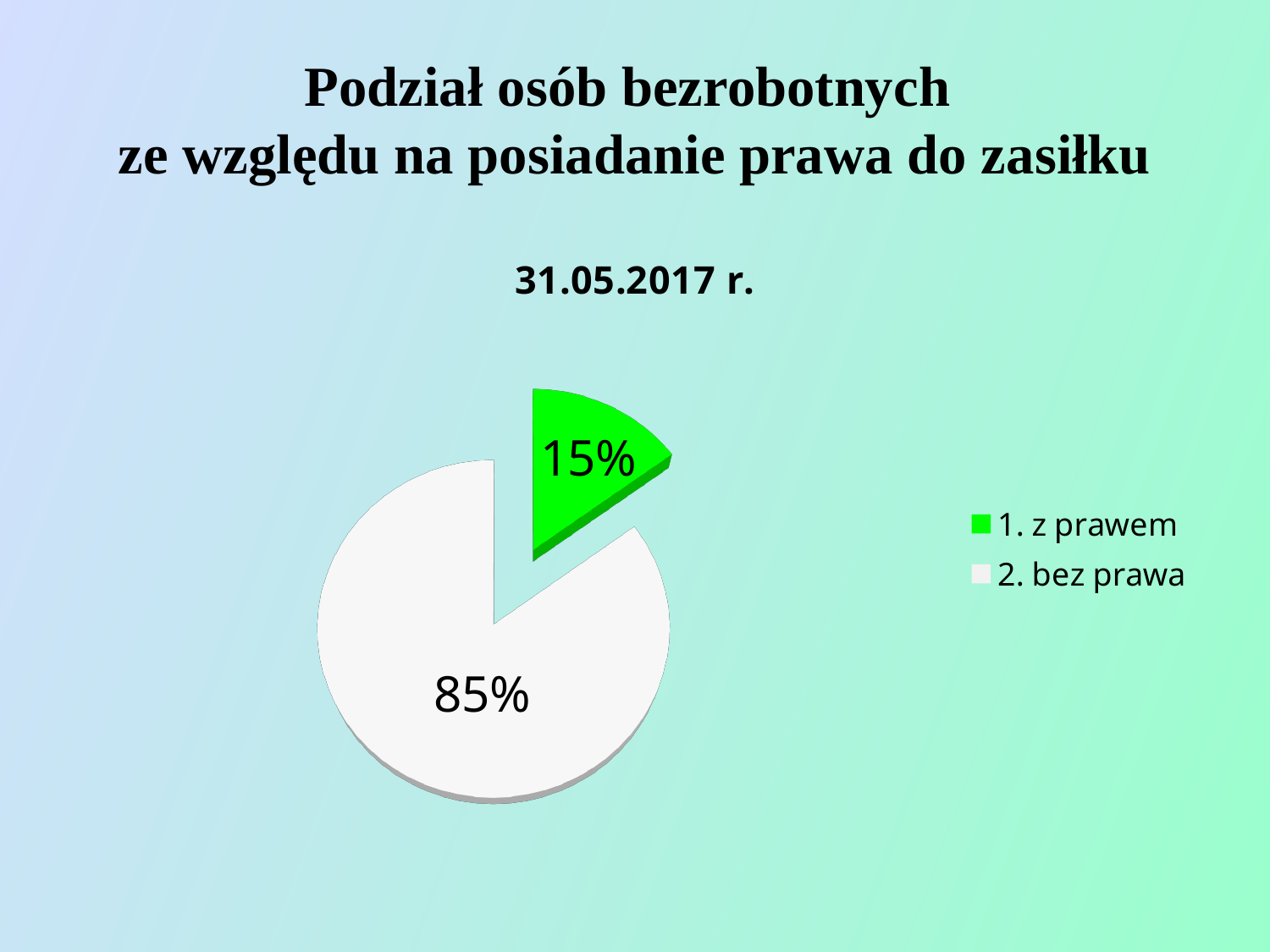
What share of the pie does "1. z prawem" represent? 15% Which is larger, the share for "1. z prawem" or for "2. bez prawa"? 2. bez prawa What is the difference in percentage points between "2. bez prawa" and "1. z prawem"? 70 What kind of chart is shown on the slide? pie chart How many entries does the legend list? 2 What colour is the slice for "1. z prawem"? green What share of the pie does "2. bez prawa" represent? 85% Which slice of the pie is the smallest? 1. z prawem How many slices does the pie chart have? 2 Which slice of the pie is the largest? 2. bez prawa What date is shown above the chart? 31.05.2017 r.